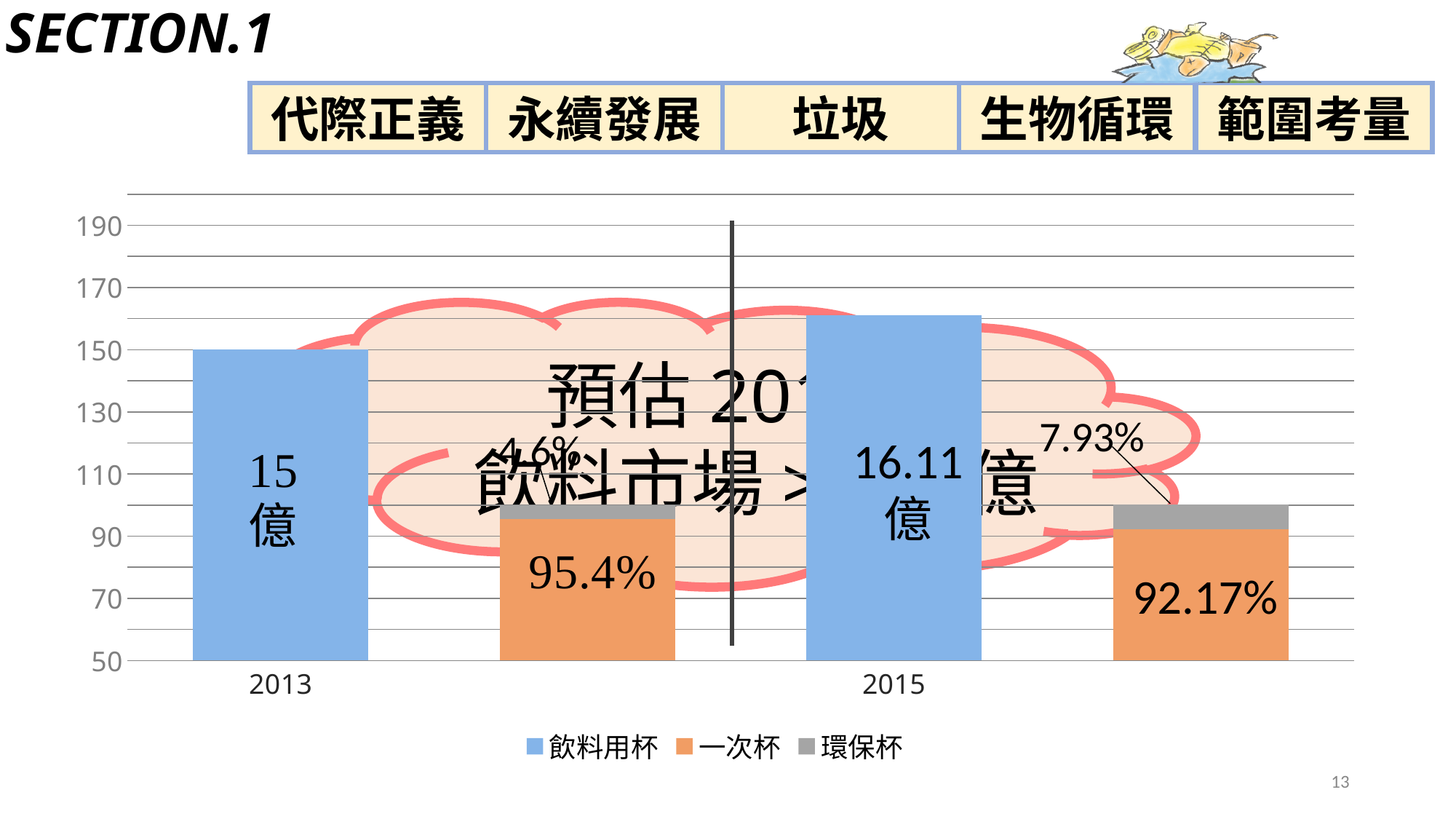
Which year has the larger value for 飲料用杯, 2013 or 2015? 2015 How many series does the legend list? 3 What kind of chart is shown on the slide? bar chart What is the value of 環保杯 for 2015? 7.93% Is the 飲料用杯 bar for 2015 greater or less than 150? greater What is the value of 飲料用杯 for 2013? 15億 Does the 飲料用杯 value rise or fall from 2013 to 2015? rise What is the difference between the 一次杯 values for 2013 and 2015? 3.23% What is the value of 一次杯 for 2015? 92.17% Which year has the larger value for 一次杯, 2013 or 2015? 2013 What is the value of 飲料用杯 for 2015? 16.11億 What is the value of 一次杯 for 2013? 95.4%